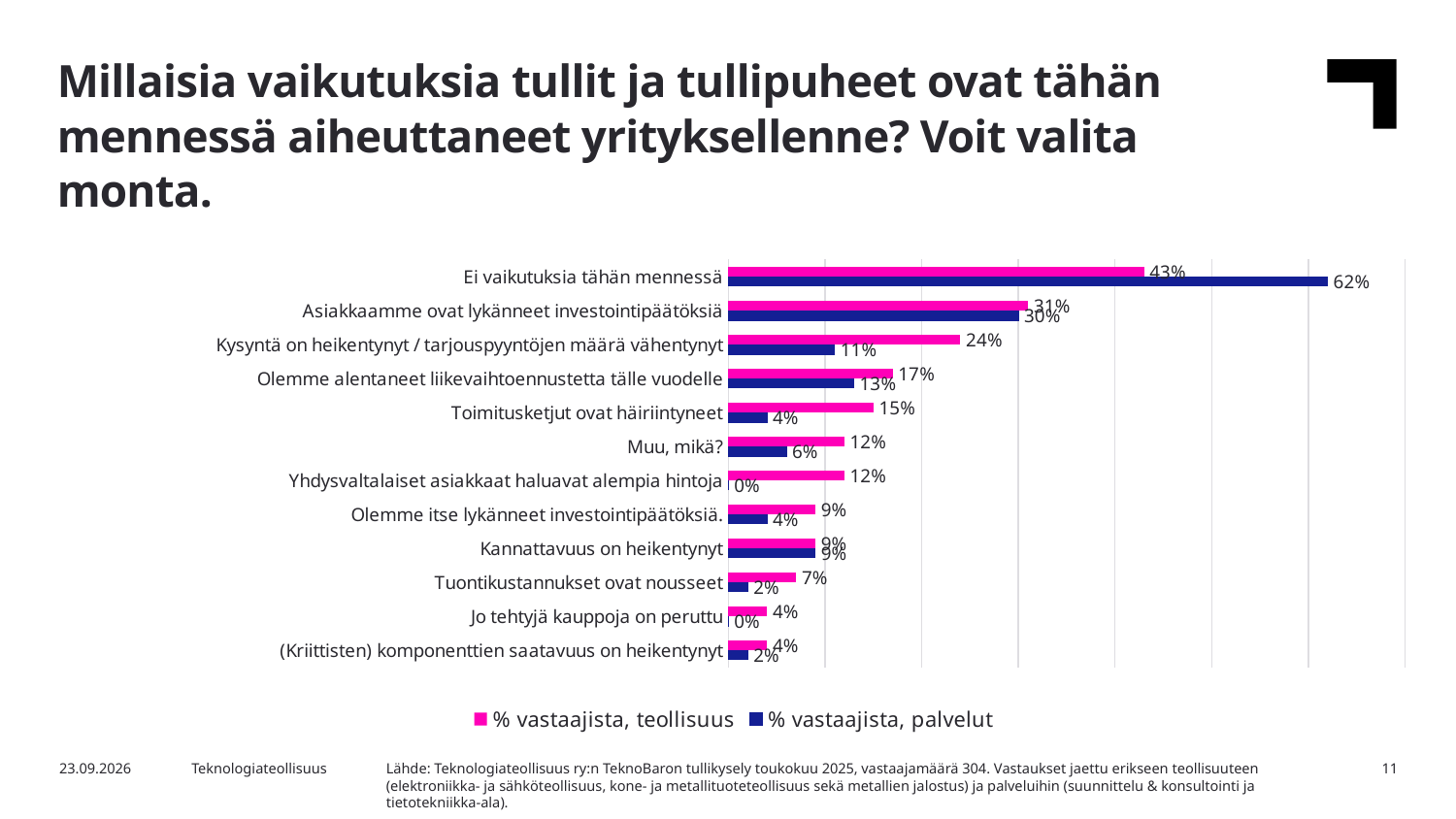
For "Olemme alentaneet liikevaihtoennustetta tälle vuodelle", which series has the larger value, "% vastaajista, teollisuus" or "% vastaajista, palvelut"? % vastaajista, teollisuus What kind of chart is shown on the slide? bar chart What is the value for "Yhdysvaltalaiset asiakkaat haluavat alempia hintoja" in the "% vastaajista, palvelut" series? 0% How many series does the legend list? 2 Which category has the highest value in the "% vastaajista, teollisuus" series? Ei vaikutuksia tähän mennessä How many categories are shown in the chart? 12 What is the value for "Toimitusketjut ovat häiriintyneet" in the "% vastaajista, palvelut" series? 4% Which colour represents the "% vastaajista, palvelut" series? blue What is the value for "Kysyntä on heikentynyt / tarjouspyyntöjen määrä vähentynyt" in the "% vastaajista, teollisuus" series? 24% What is the value for "Ei vaikutuksia tähän mennessä" in the "% vastaajista, palvelut" series? 62% What is the difference between the "% vastaajista, palvelut" and "% vastaajista, teollisuus" values for "Ei vaikutuksia tähän mennessä"? 19% What is the difference between the "% vastaajista, teollisuus" and "% vastaajista, palvelut" values for "Kysyntä on heikentynyt / tarjouspyyntöjen määrä vähentynyt"? 13%